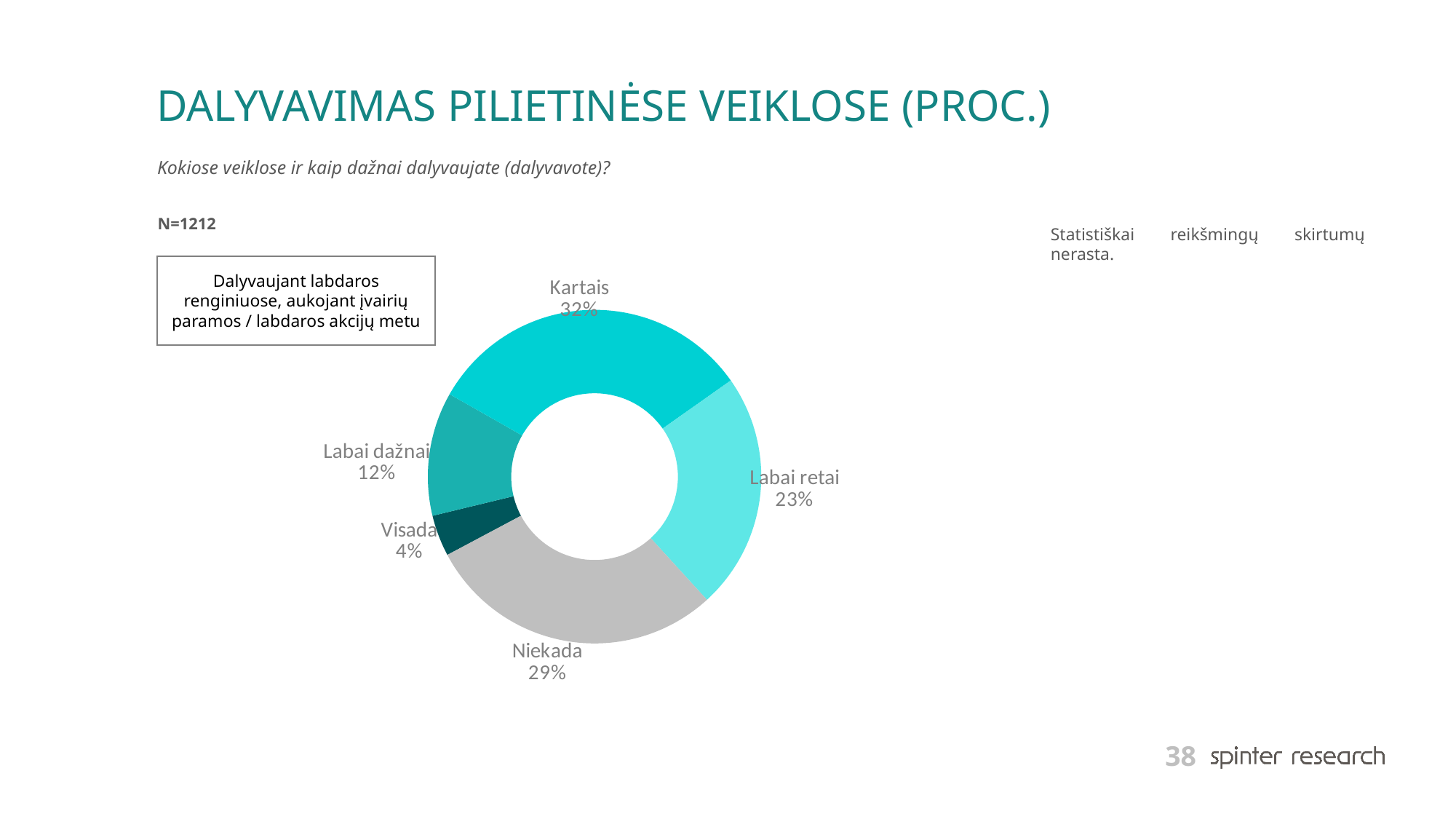
What percentage of respondents answered "Visada"? 4% Which category has the smallest share of the chart? Visada Which is larger, the share for "Labai retai" or the share for "Labai dažnai"? Labai retai What is the difference in percentage points between "Labai dažnai" and "Visada"? 8 What percentage of respondents answered "Kartais"? 32% What is the difference in percentage points between "Kartais" and "Niekada"? 3 How many categories are shown in the chart? 5 What kind of chart is shown on the slide? Doughnut (pie) chart What is the sample size (N) stated on the slide? N=1212 Which category has the largest share of the chart? Kartais What percentage of respondents answered "Labai retai"? 23% What percentage of respondents answered "Niekada"? 29%